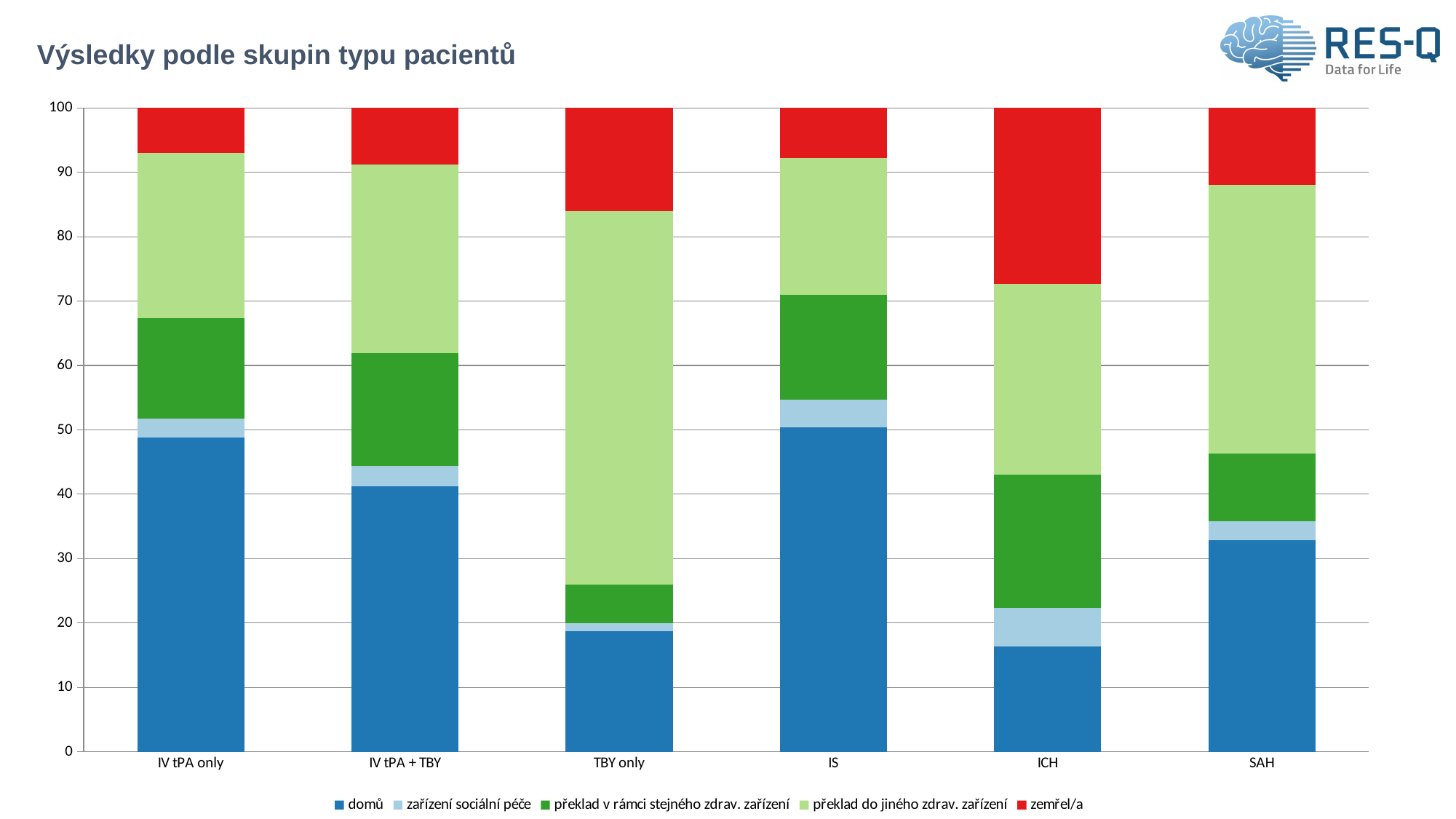
Which patient group has the largest 'překlad do jiného zdrav. zařízení' segment? TBY only How many series does the legend list? 5 Is the 'domů' value for TBY only greater or less than 30? less Is the 'domů' value for ICH greater or less than 20? less Is the 'domů' value for IS greater or less than 40? greater What is the title of the chart? Výsledky podle skupin typu pacientů Which patient group has the largest 'zemřel/a' segment? ICH How many patient groups are shown on the x axis? 6 What is the total height of the stacked bar for IS? 100 Which is larger, the 'domů' value for IV tPA only or for SAH? IV tPA only Which is larger, the 'zemřel/a' segment for ICH or for SAH? ICH What kind of chart is shown on the slide? stacked bar chart